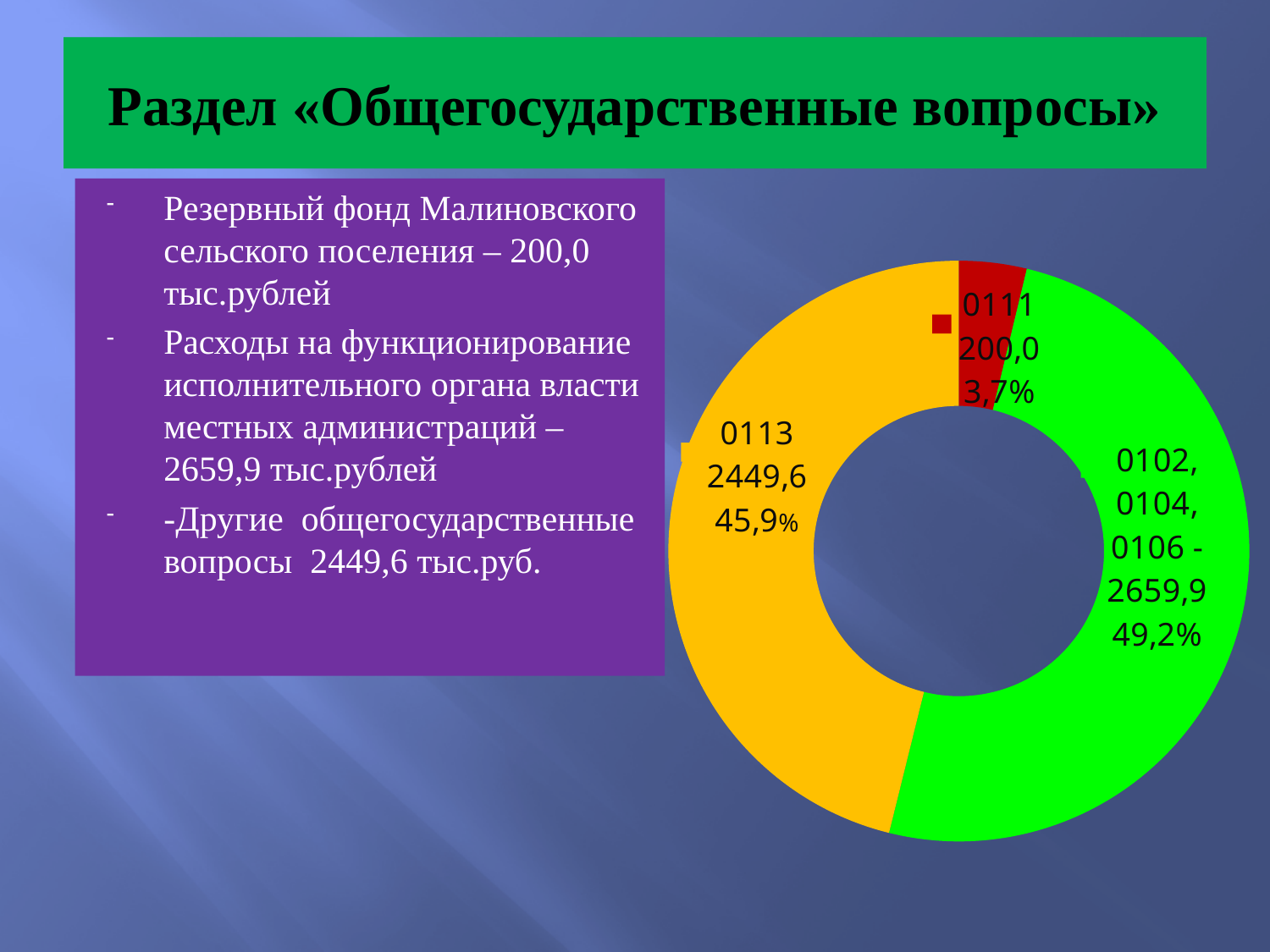
Which slice has the smallest value? 0111 What colour is the slice for 0111? red What is the value shown for slice 0111? 200,0 What is the value shown for slice 0113? 2449,6 What percentage share is shown for slice 0113? 45,9% What kind of chart is shown on the slide? doughnut chart How many slices does the doughnut chart have? 3 What is the difference between the values of slice 0102, 0104, 0106 and slice 0113? 210,3 What percentage share is shown for the slice labelled 0102, 0104, 0106? 49,2% What percentage share is shown for slice 0111? 3,7% What is the value shown for the slice labelled 0102, 0104, 0106? 2659,9 Which slice has the largest value? 0102, 0104, 0106